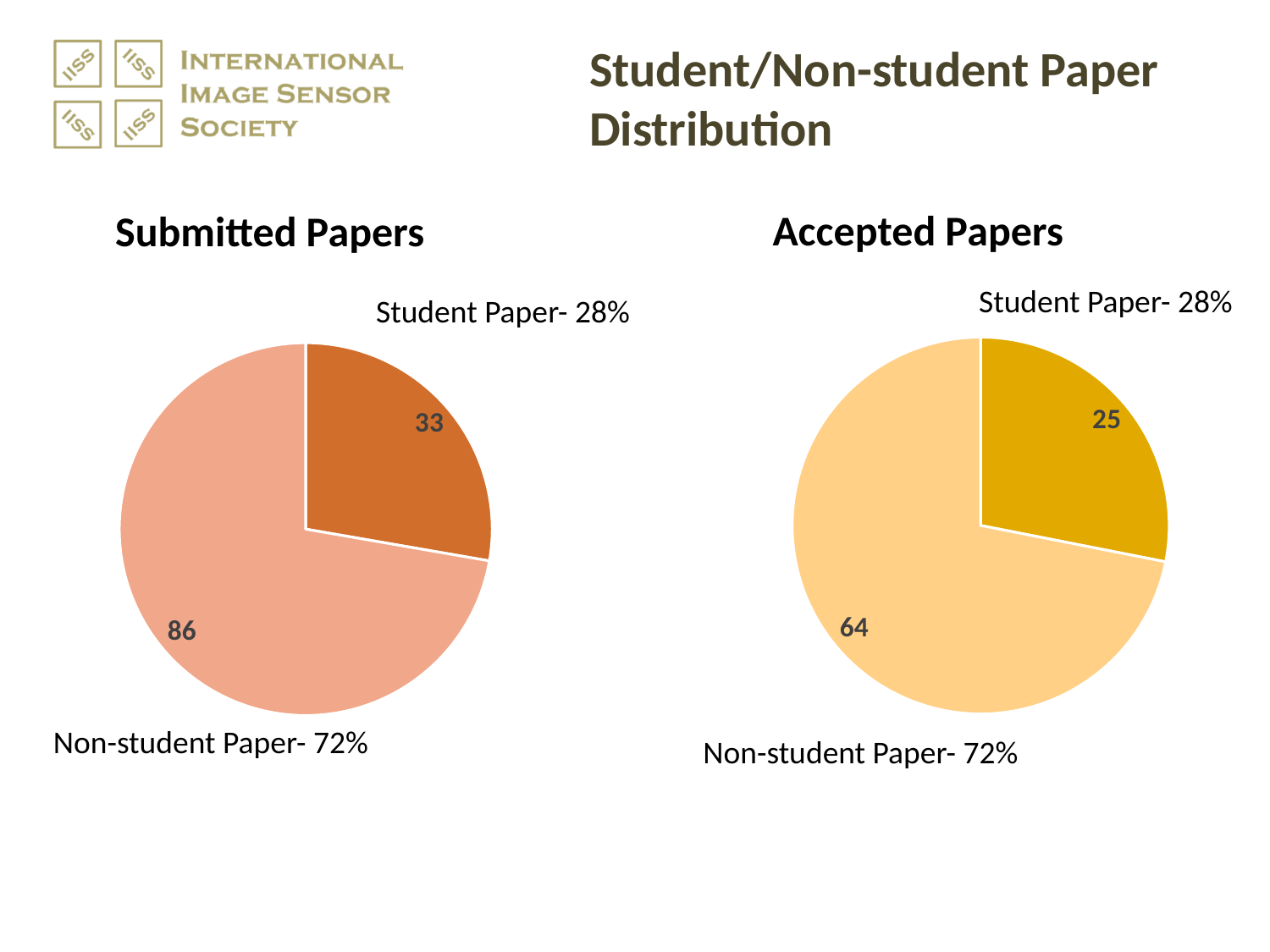
In the Accepted Papers chart, how many non-student papers are shown? 64 In the Submitted Papers chart, how many student papers are shown? 33 In the Accepted Papers chart, what is the total number of papers across both slices? 89 In the Accepted Papers chart, what share of the pie is the Non-student Paper slice? 72% What kind of chart is the Accepted Papers chart? Pie chart In the Submitted Papers chart, what share of the pie is the Student Paper slice? 28% In the Submitted Papers chart, which category has the largest slice? Non-student Paper How many slices does the Submitted Papers pie chart have? 2 In the Submitted Papers chart, how many non-student papers are shown? 86 In the Accepted Papers chart, which category has the smallest slice? Student Paper In the Submitted Papers chart, what is the difference between the non-student and student paper counts? 53 In the Accepted Papers chart, how many student papers are shown? 25